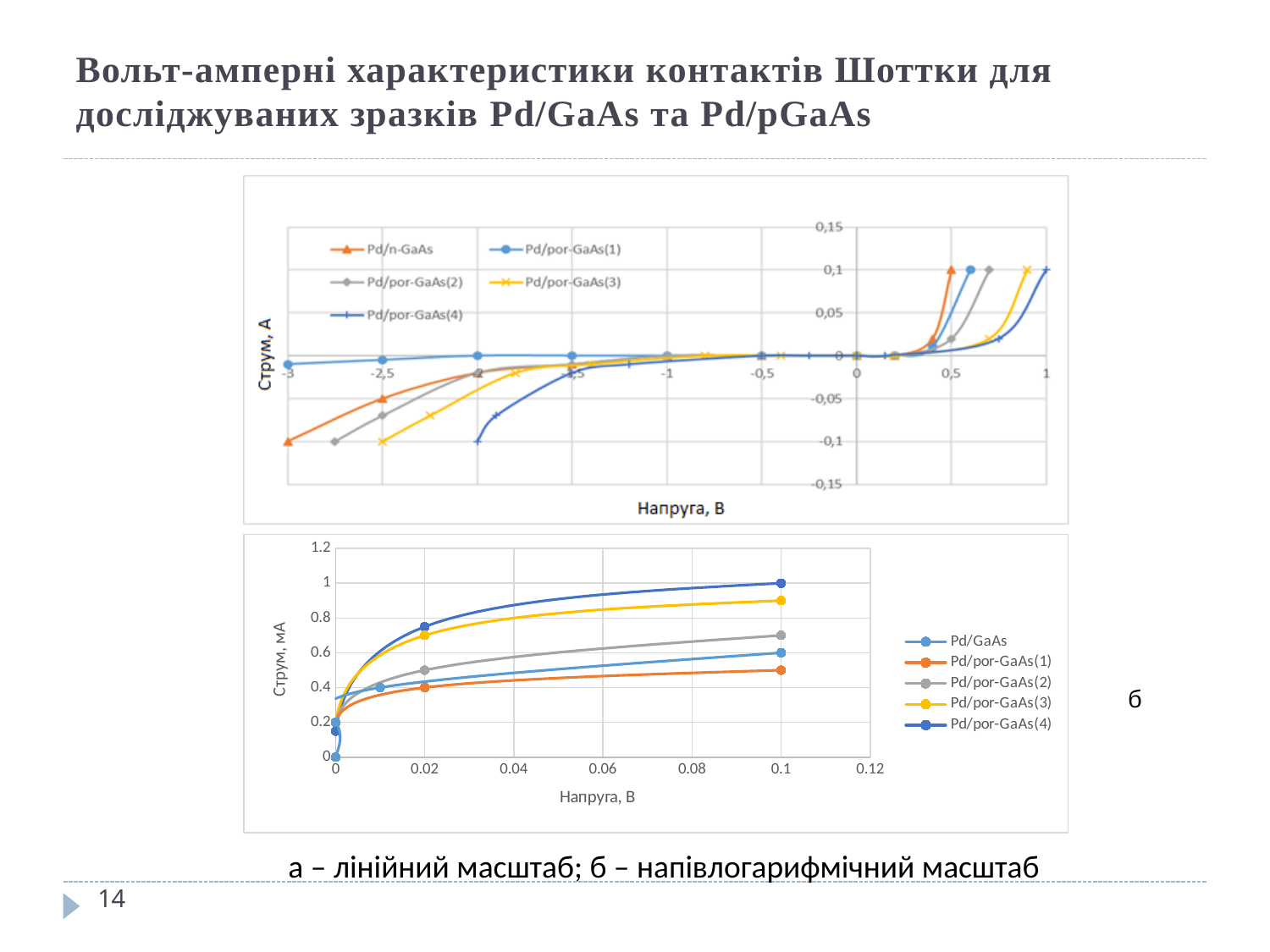
What kind of chart is the top chart (a)? line chart In the bottom chart (b), does the Pd/por-GaAs(4) series rise or fall as voltage increases? rise In the top chart (a), is the value for Pd/por-GaAs(1) at -3 V greater or less than -0,05? greater In the bottom chart (b), which is larger at 0.1 V: Pd/por-GaAs(3) or Pd/por-GaAs(2)? Pd/por-GaAs(3) What is the y-axis label of the bottom chart (b)? Струм, мА In the bottom chart (b), is the value for Pd/por-GaAs(1) at 0.1 V greater or less than 0.6? less In the bottom chart (b), which series has the lowest value at 0.1 V? Pd/por-GaAs(1) In the bottom chart (b), which series has the highest value at 0.1 V? Pd/por-GaAs(4) In the bottom chart (b), is the value for Pd/por-GaAs(4) at 0.1 V greater or less than 0.8? greater What is the x-axis label of the top chart (a)? Напруга, В How many series does the legend of the top chart (a) list? 5 How many series does the legend of the bottom chart (b) list? 5